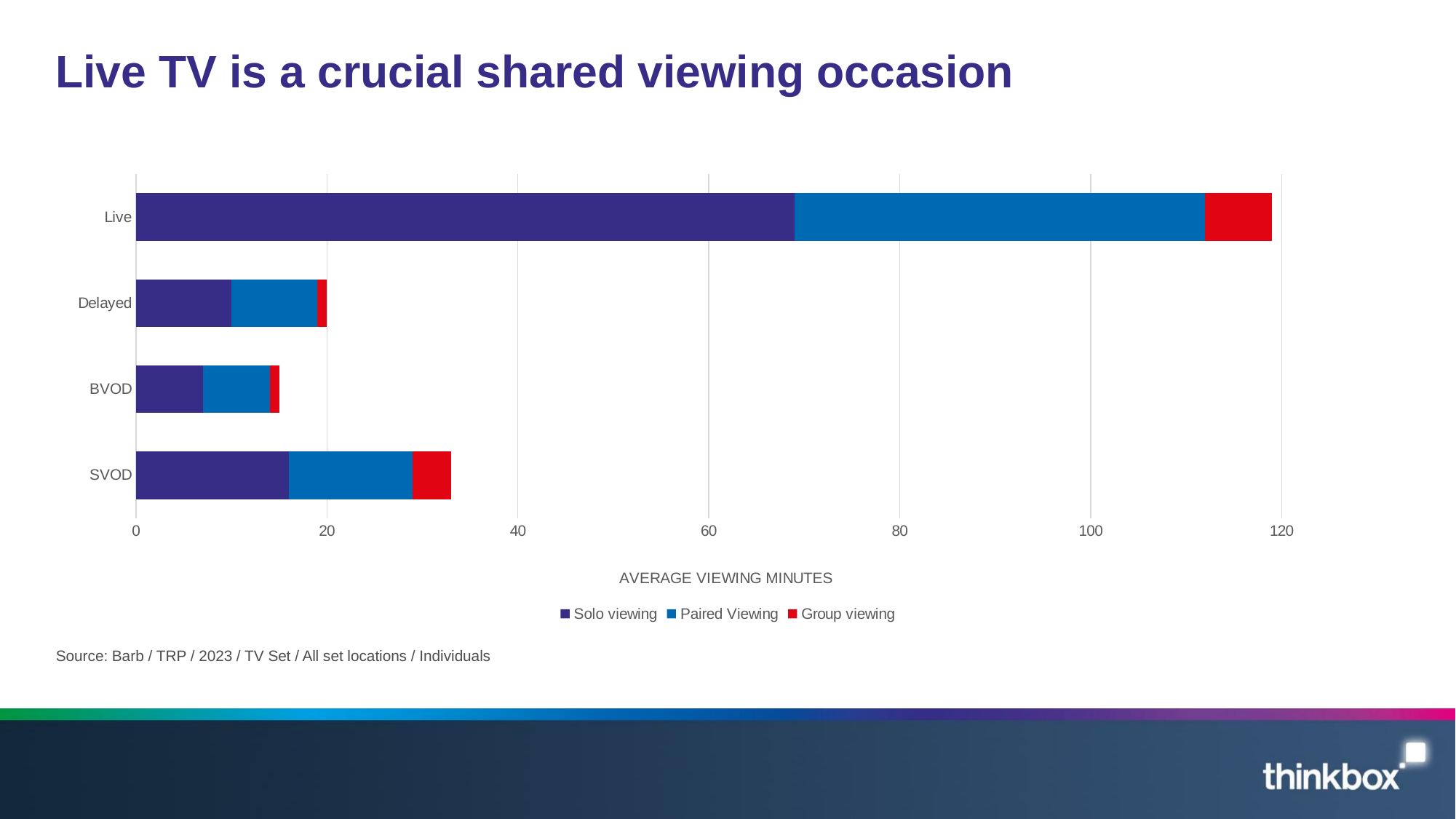
How many series does the legend list? 3 What is the label on the horizontal axis of the chart? AVERAGE VIEWING MINUTES Is the total value for Live greater or less than 100? greater Which category has the longest total bar? Live What kind of chart is shown on the slide? bar chart Is the total value for Delayed greater or less than 40? less Is the total value for SVOD greater or less than 20? greater Which series is shown in red in the legend? Group viewing Which category has the shortest total bar? BVOD Which has a longer total bar, SVOD or Delayed? SVOD How many categories are plotted on the chart? 4